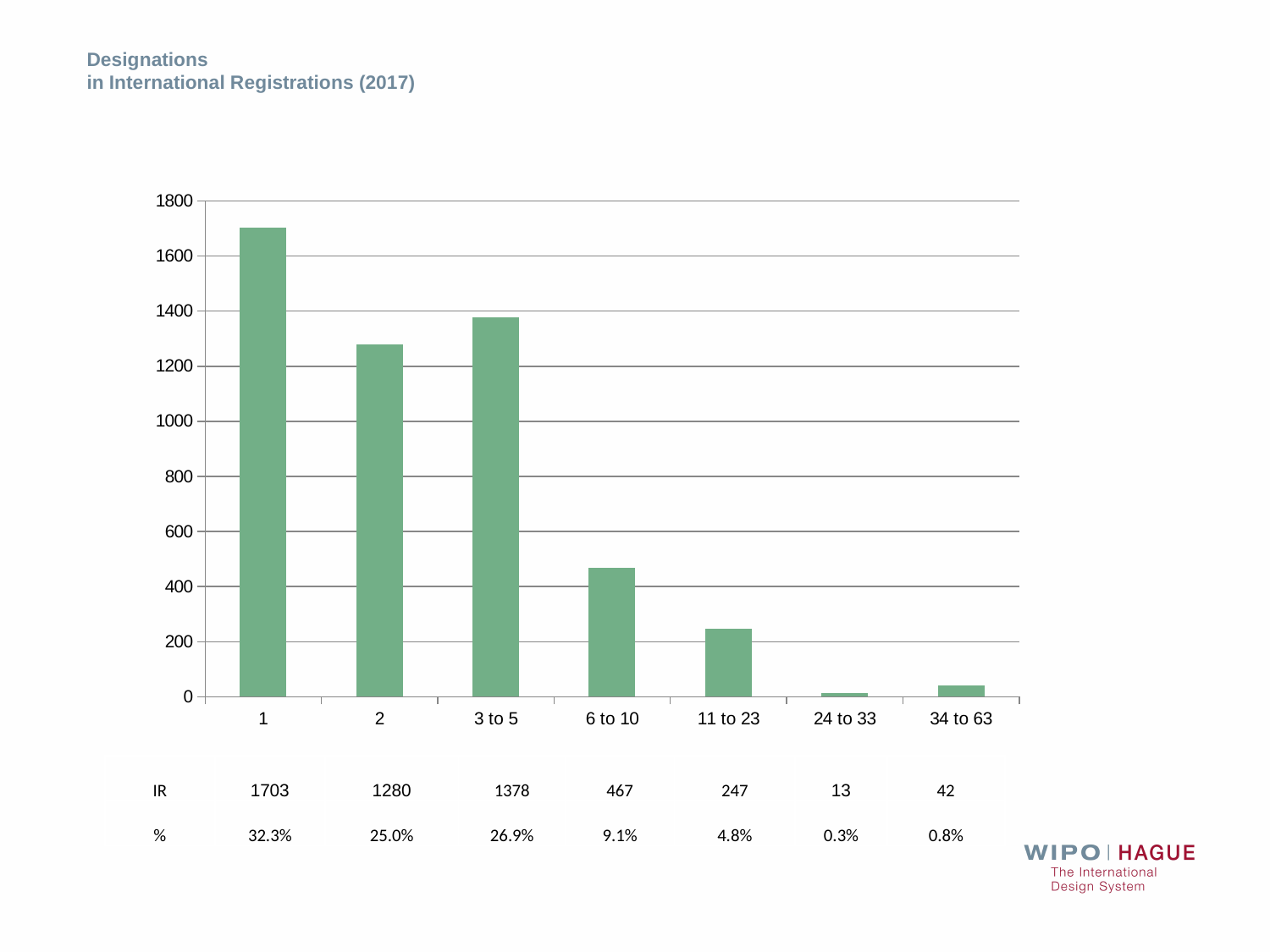
What is the IR value for the category '24 to 33'? 13 Which category has the highest IR value? 1 What is the IR value for the category '1'? 1703 What kind of chart is shown on the slide? bar chart What is the title of the slide? Designations in International Registrations (2017) What is the difference between the IR values for '1' and '2'? 423 Which has a larger IR value, '2' or '3 to 5'? 3 to 5 Which category has the lowest IR value? 24 to 33 What is the IR value for the category '3 to 5'? 1378 What percentage is shown for the category '6 to 10'? 9.1% How many categories are shown on the x axis? 7 Is the value for '11 to 23' greater or less than 400? less